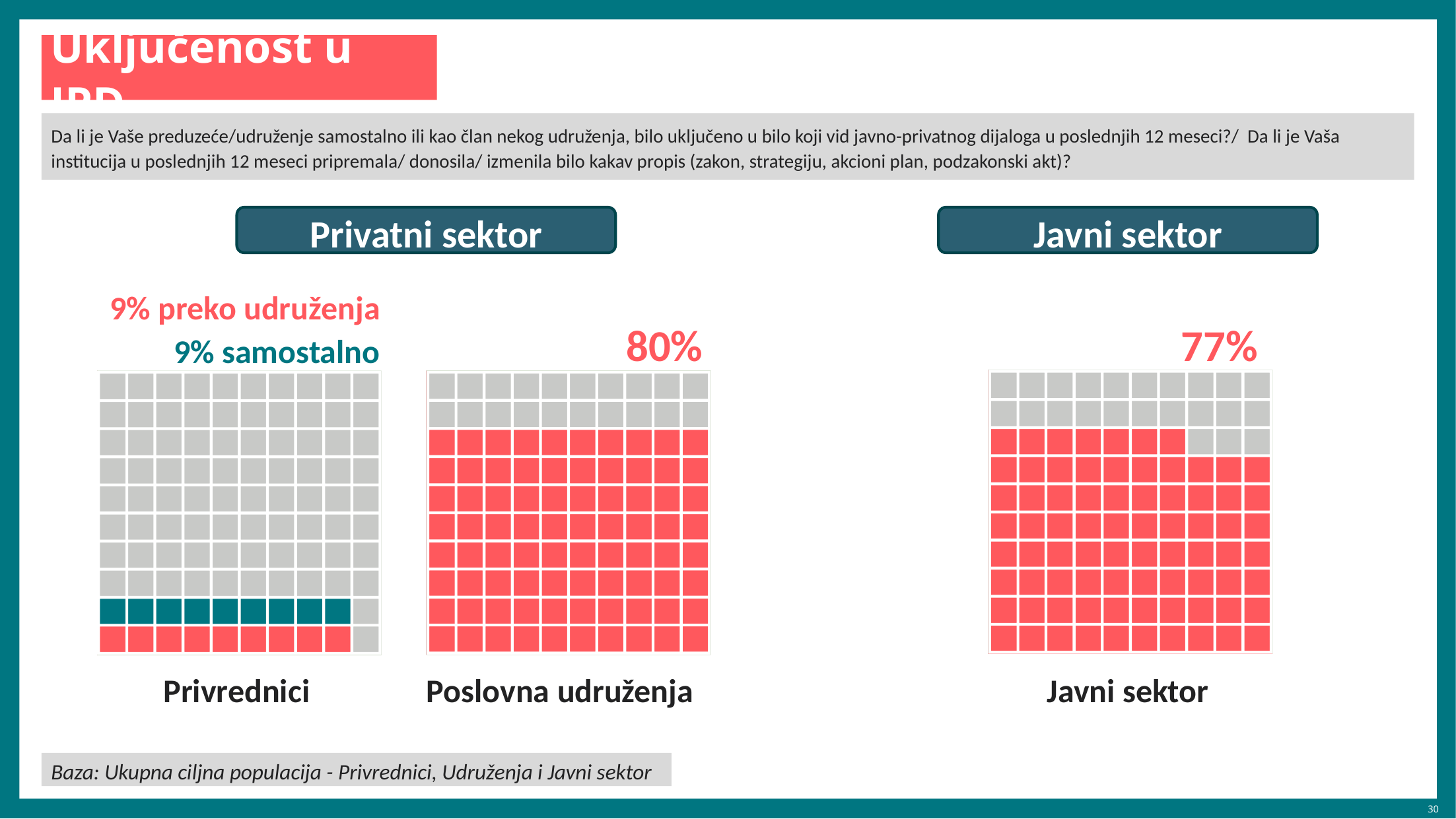
Which of the three charts shows the lowest total percentage? Privrednici What is the combined percentage shown for Privrednici (preko udruženja plus samostalno)? 18% What is the difference in percentage points between the Poslovna udruženja value and the Javni sektor value? 3 percentage points Which sector heading appears above the Privrednici and Poslovna udruženja charts? Privatni sektor What value is shown for the Javni sektor chart? 77% In the Privrednici chart, what percentage is labelled 'samostalno'? 9% What kind of chart is used to display the percentages on this slide? Waffle chart What value is shown for the Poslovna udruženja chart? 80% How many waffle charts are shown on the slide? 3 Which of the three charts shows the highest percentage? Poslovna udruženja Which is larger, the value for Poslovna udruženja or the value for Javni sektor? Poslovna udruženja In the Privrednici chart, what percentage is labelled 'preko udruženja'? 9%